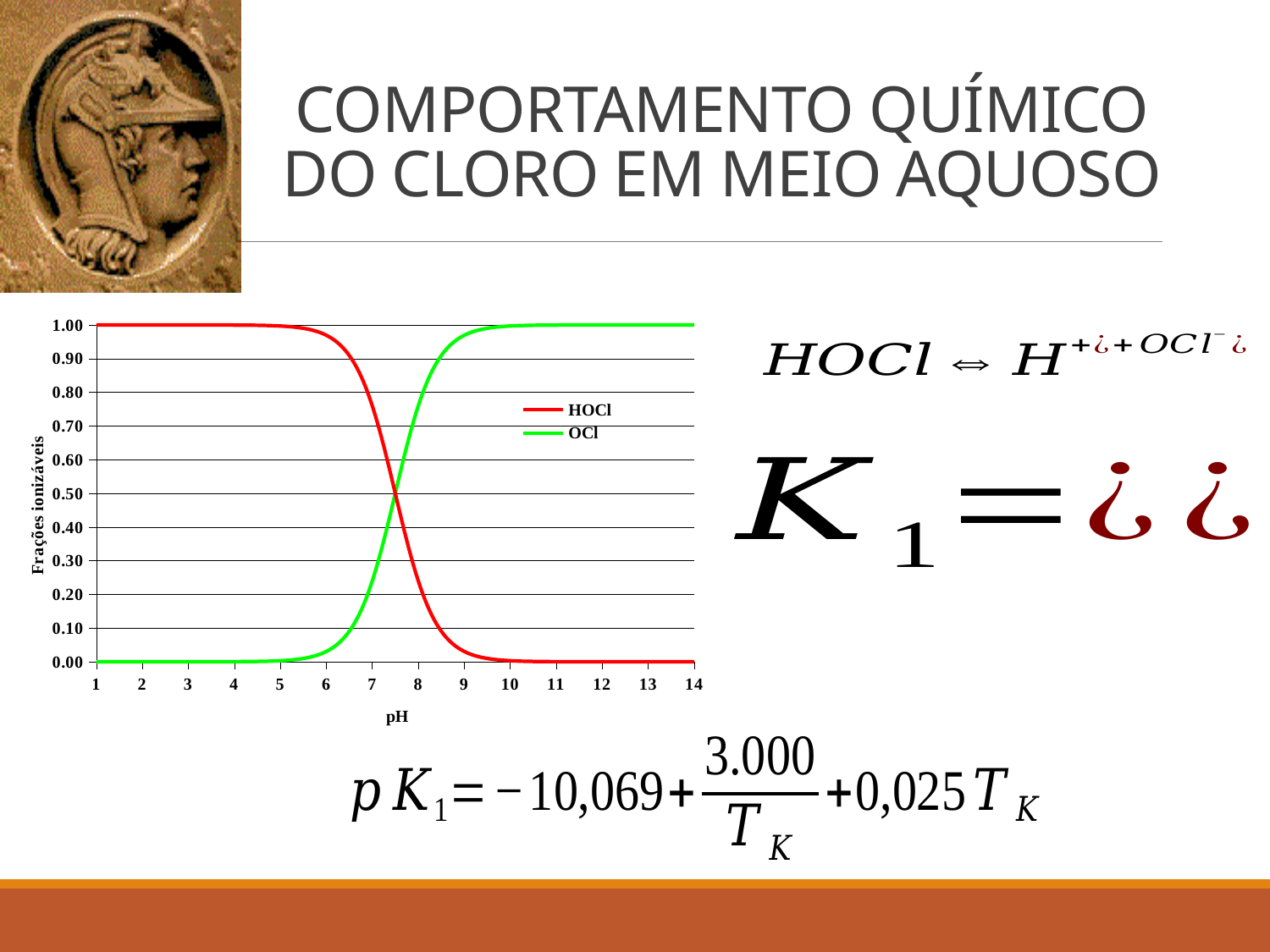
Does the HOCl series rise or fall as pH increases? fall Is the value of the OCl series at pH 6 greater or less than 0.10? less How many series does the chart legend list? 2 Is the value of the HOCl series at pH 5 greater or less than 0.90? greater At pH 9, which series has the larger value, HOCl or OCl? OCl At pH 7, which series has the larger value, HOCl or OCl? HOCl What kind of chart is shown on the slide? line chart What are the two series named in the chart legend? HOCl and OCl What is the label of the x axis of the chart? pH Is the value of the HOCl series at pH 9 greater or less than 0.10? less How many pH values are marked along the x axis of the chart? 14 Does the OCl series rise or fall as pH increases? rise